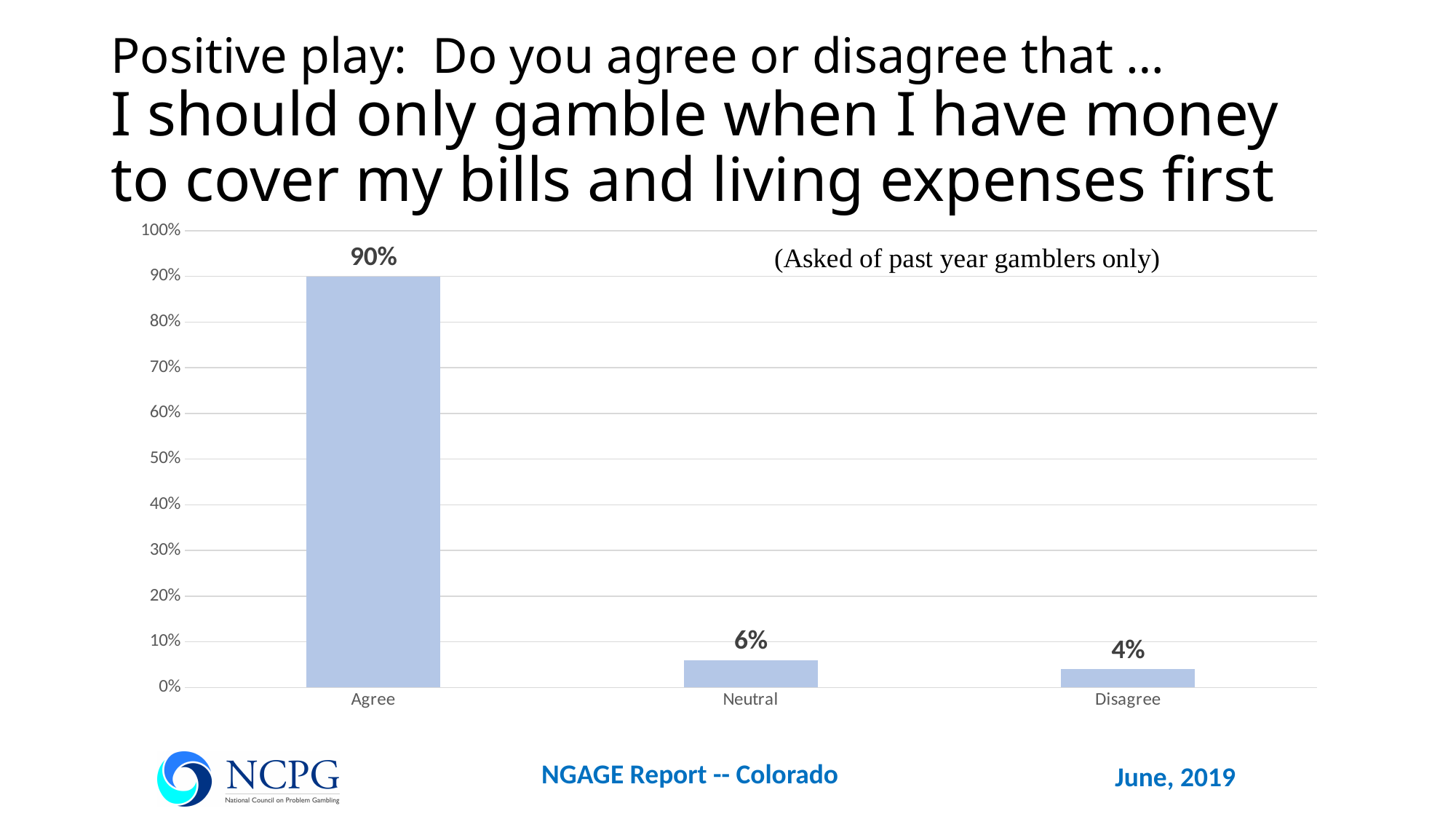
What is the difference in percentage points between Agree and Disagree? 86 What percentage of respondents chose Agree? 90% What kind of chart is shown on the slide? bar chart Which is larger, the value for Neutral or the value for Disagree? Neutral What is the difference in percentage points between Neutral and Disagree? 2 What percentage of respondents chose Disagree? 4% What percentage of respondents chose Neutral? 6% According to the note on the chart, who was this question asked of? Past year gamblers only Which response category has the highest value? Agree Which response category has the lowest value? Disagree How many response categories are shown on the x axis? 3 Is the value for Agree greater or less than 80%? greater